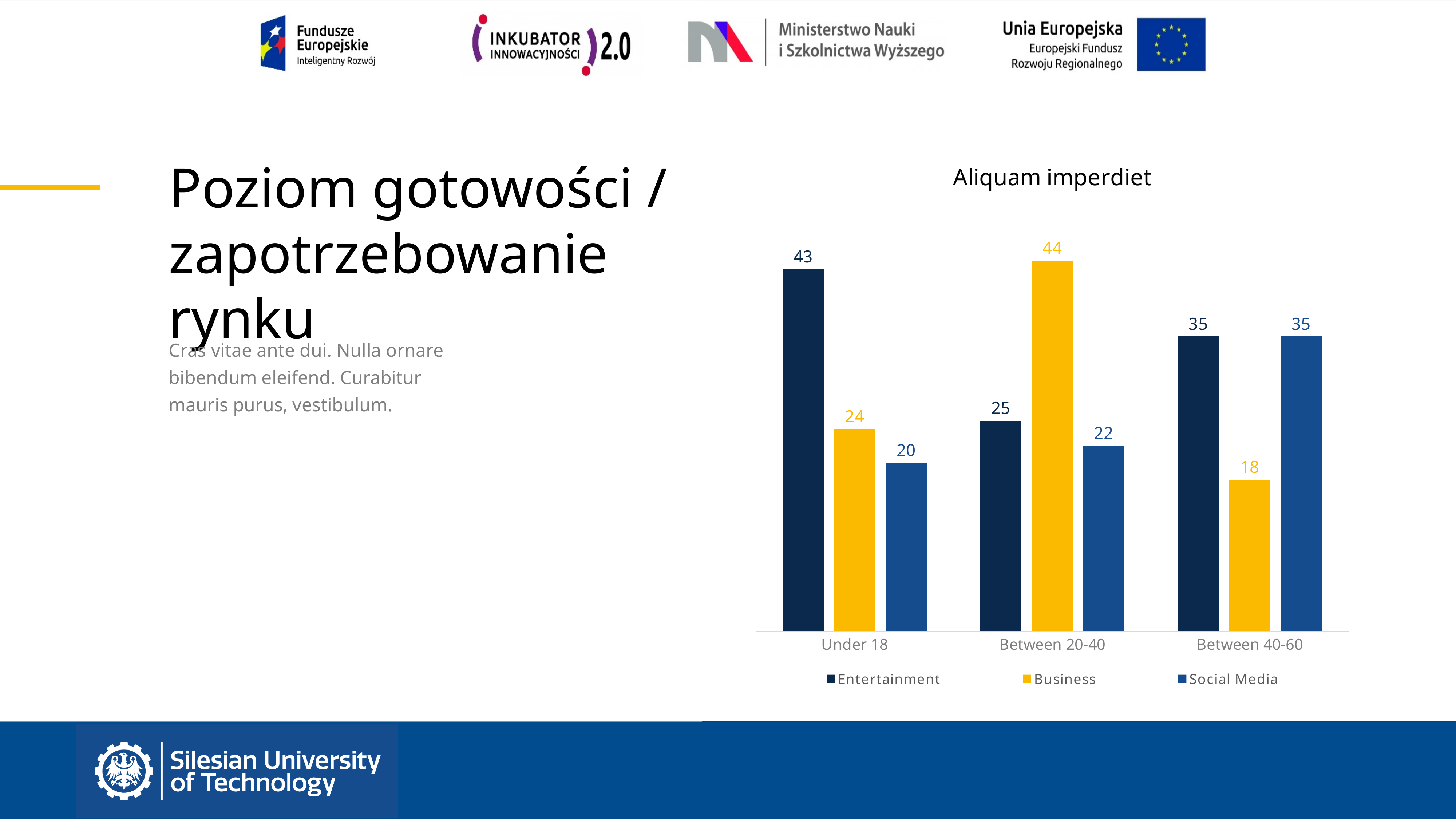
How many categories are shown on the x axis? 3 What is the difference between the Entertainment and Business values in the Under 18 category? 19 What is the value for Business in the Between 40-60 category? 18 What is the title of the chart? Aliquam imperdiet What kind of chart is shown on the slide? Bar chart What is the value for Business in the Between 20-40 category? 44 What is the value for Social Media in the Between 40-60 category? 35 Which category has the highest Business value? Between 20-40 Which is larger in the Between 20-40 category, Entertainment or Social Media? Entertainment What is the value for Entertainment in the Under 18 category? 43 How many series does the legend list? 3 Which category has the lowest Social Media value? Under 18